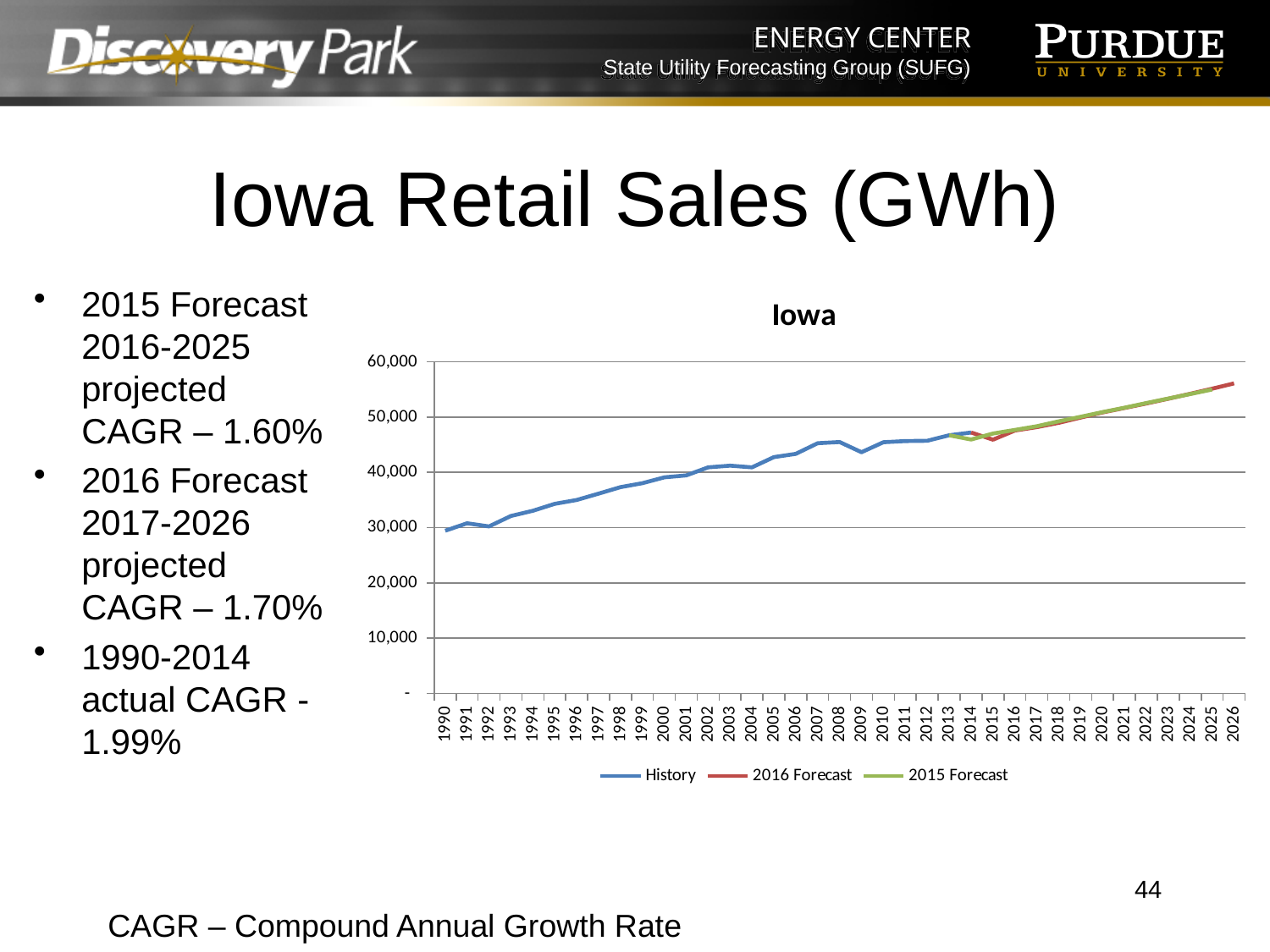
Is the value for 2026 in the 2016 Forecast series greater or less than 50,000? greater Which year has the lowest History value in the chart? 1990 Does the History series generally rise or fall from 1990 to 2014? Rise Is the History value for 2005 greater or less than 40,000? greater Is the History value for 2010 greater or less than 40,000? greater What is the title of the chart? Iowa How many series does the chart legend list? 3 What kind of chart is shown on the slide? Line chart Which series is drawn in blue in the chart? History How many years are labeled on the x axis of the chart? 37